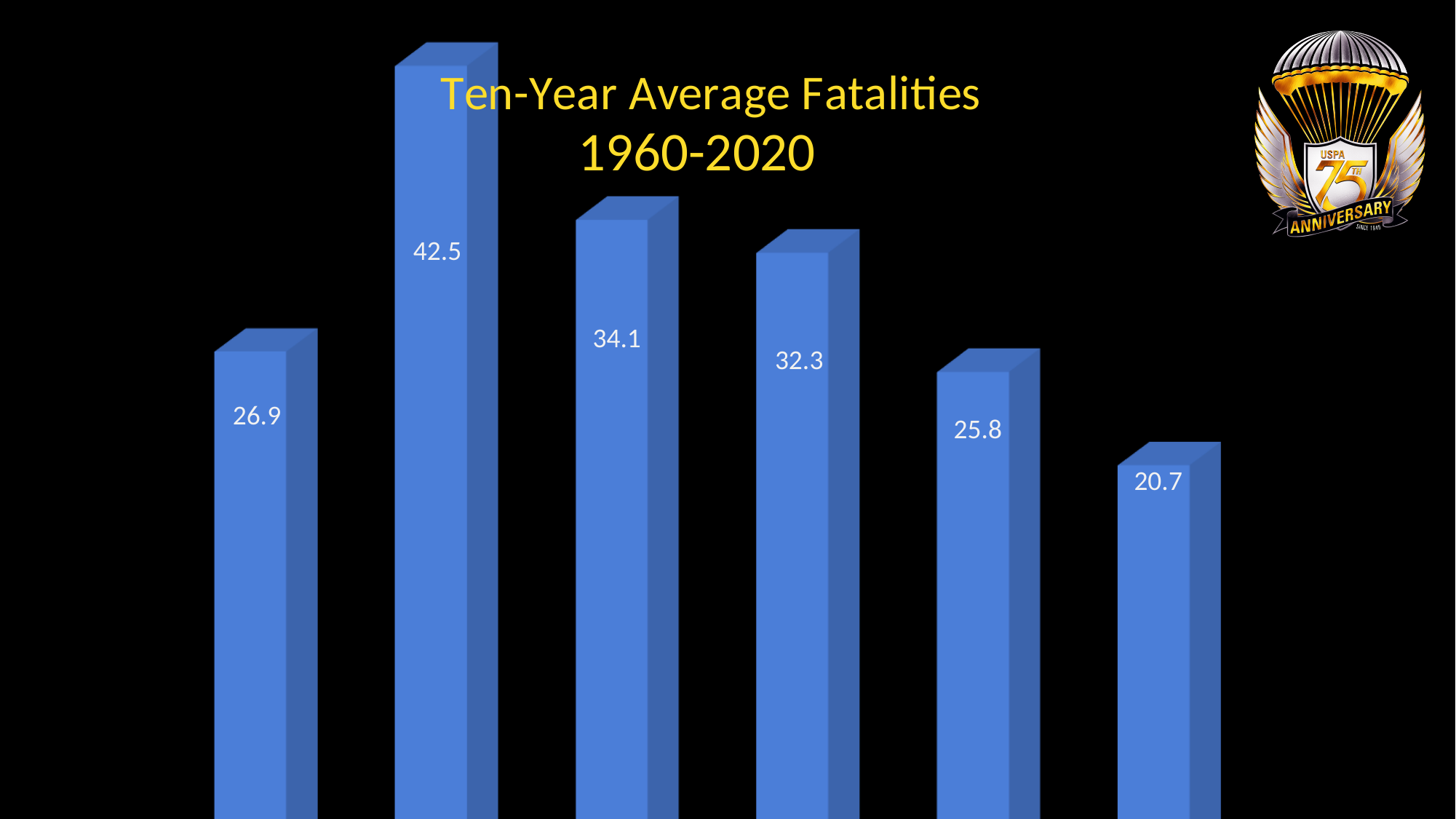
What type of chart is shown on the slide? bar chart What is the value shown on the fourth bar from the left? 32.3 What is the value shown on the last (rightmost) bar? 20.7 What is the difference between the highest bar (42.5) and the lowest bar (20.7)? 21.8 Which is larger, the value of the third bar from the left or the value of the fourth bar from the left? the third bar (34.1) How many bars are plotted in the chart? 6 What is the title of the chart? Ten-Year Average Fatalities 1960-2020 What is the value shown on the second bar from the left? 42.5 What is the highest value shown in the chart? 42.5 What is the value shown on the first (leftmost) bar? 26.9 From the second bar onward, do the values rise or fall moving left to right? fall What is the lowest value shown in the chart? 20.7